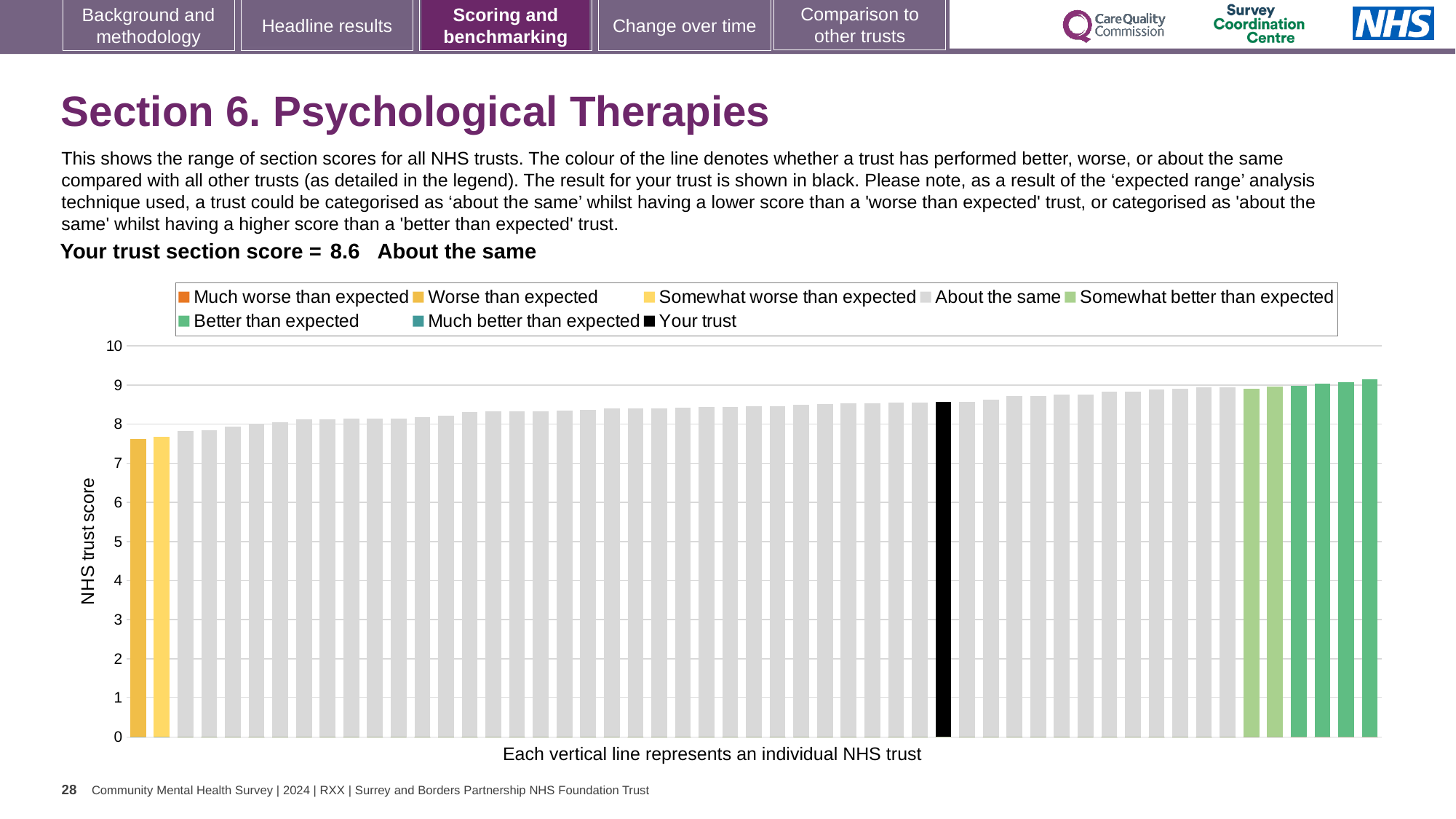
Which is larger: the value for your trust (black bar) or the leftmost bar? Your trust Which category does your trust fall into for this section? About the same What is the section score for your trust shown on the slide? 8.6 Is the value of the leftmost (lowest) bar greater or less than 8? less What kind of chart is shown on the slide? Bar chart What colour is used for the bar representing your trust? Black Do the bar values rise or fall from left to right across the chart? Rise What is the label on the vertical axis of the chart? NHS trust score Is the value for your trust (black bar) greater or less than 8? greater How many bars are coloured in yellow shades (worse than expected categories)? 2 How many entries does the chart legend list? 8 Is the value of the rightmost (highest) bar greater or less than 8? greater